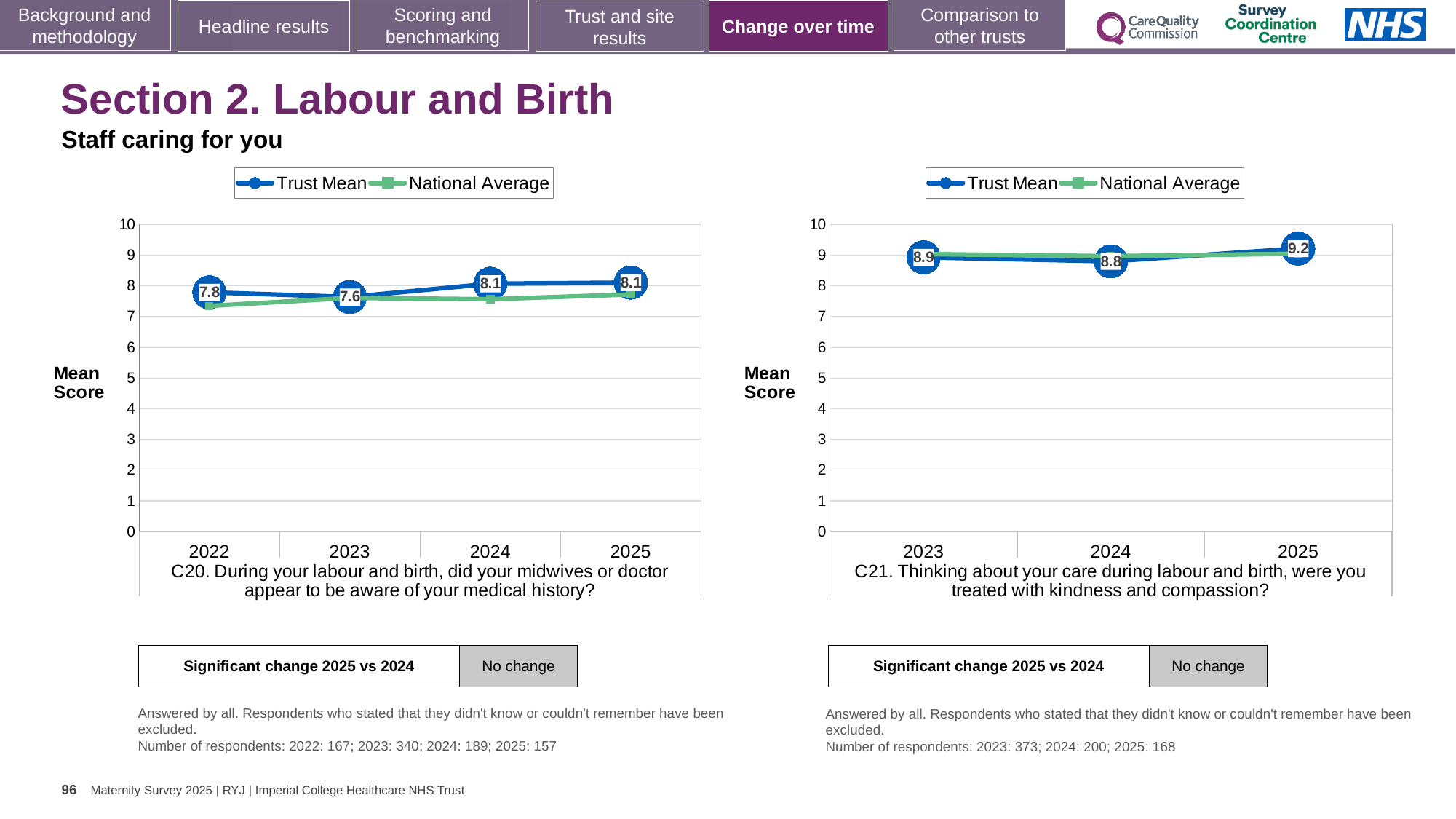
In the C20 chart on the left, what is the Trust Mean for 2023? 7.6 In the C20 chart on the left, is the National Average for 2022 greater or less than 8? less What kind of chart is the C21 chart on the right? Line chart In the C20 chart on the left, is the Trust Mean higher in 2022 or in 2025? 2025 In the C20 chart on the left, what is the Trust Mean for 2025? 8.1 How many series does the legend of the C20 chart on the left list? 2 In the C20 chart on the left, which year has the lowest Trust Mean? 2023 In the C21 chart on the right, what is the Trust Mean for 2025? 9.2 How many years are shown on the x axis of the C21 chart on the right? 3 In the C20 chart on the left, what is the difference between the Trust Mean for 2024 and for 2023? 0.5 In the C21 chart on the right, which year has the lowest Trust Mean? 2024 In the C21 chart on the right, what is the difference between the Trust Mean for 2025 and for 2024? 0.4